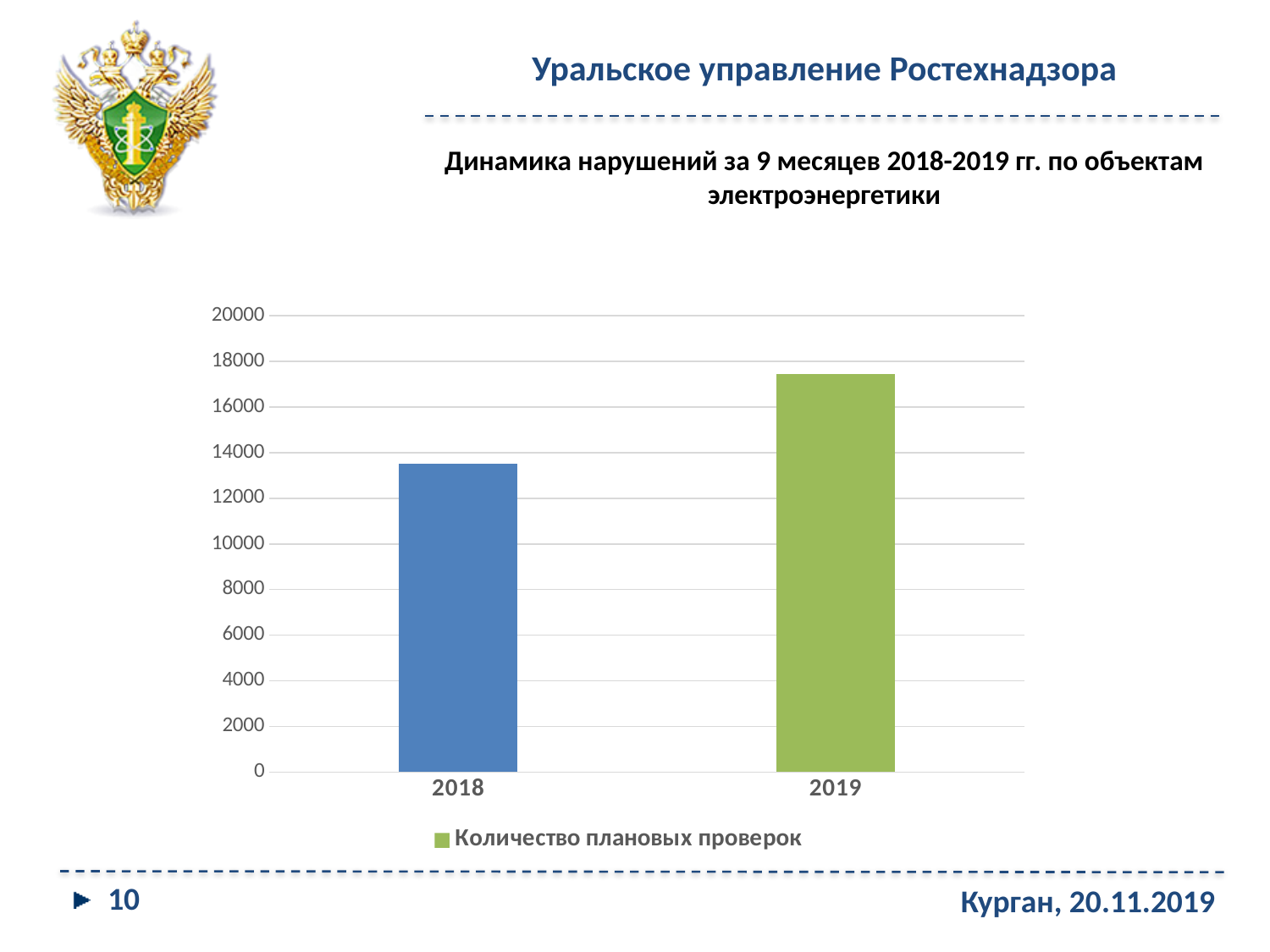
Which is larger, the value for 2018 or the value for 2019? 2019 How many categories are shown on the x axis of the chart? 2 Is the value for 2019 greater or less than 18000? less Which year has the highest bar in the chart? 2019 Do the values rise or fall from 2018 to 2019? rise What kind of chart is shown on the slide? bar chart Is the value for 2018 greater or less than 12000? greater How many series does the chart legend list? 1 Is the value for 2019 greater or less than 16000? greater Which year has the lowest bar in the chart? 2018 What is the legend entry shown below the chart? Количество плановых проверок